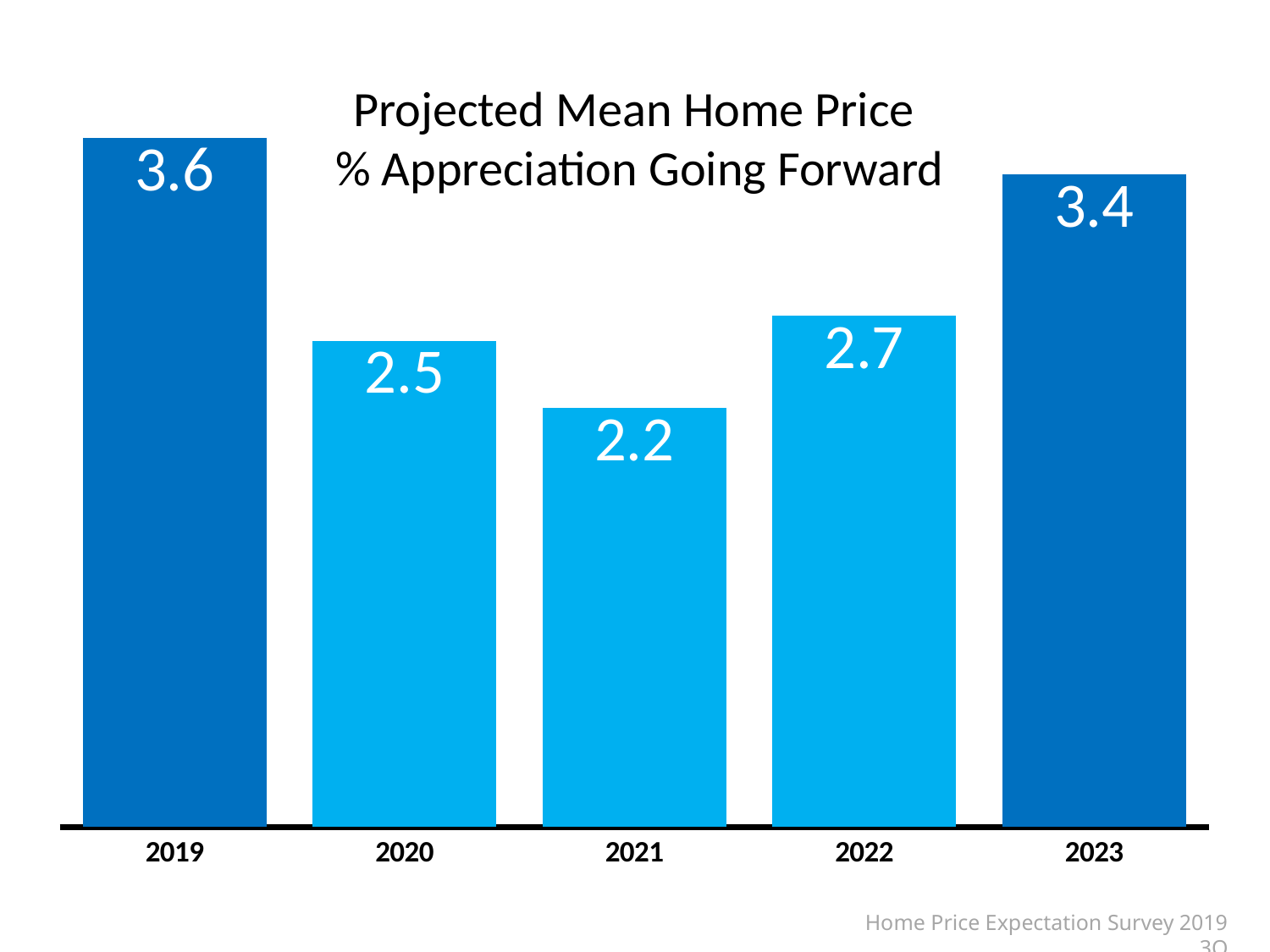
How many years are shown on the chart? 5 Does the projected appreciation rise or fall from 2021 to 2023? Rise What is the difference between the projected appreciation for 2022 and 2021? 0.5 Which year has a higher projected appreciation, 2020 or 2022? 2022 Which year has the lowest projected mean home price appreciation? 2021 What kind of chart is shown on the slide? Bar chart What is the difference between the projected appreciation for 2019 and 2023? 0.2 What is the projected mean home price appreciation for 2023? 3.4 Which year has the highest projected mean home price appreciation? 2019 What is the projected mean home price appreciation for 2019? 3.6 What is the title of the chart? Projected Mean Home Price % Appreciation Going Forward What is the projected mean home price appreciation for 2021? 2.2